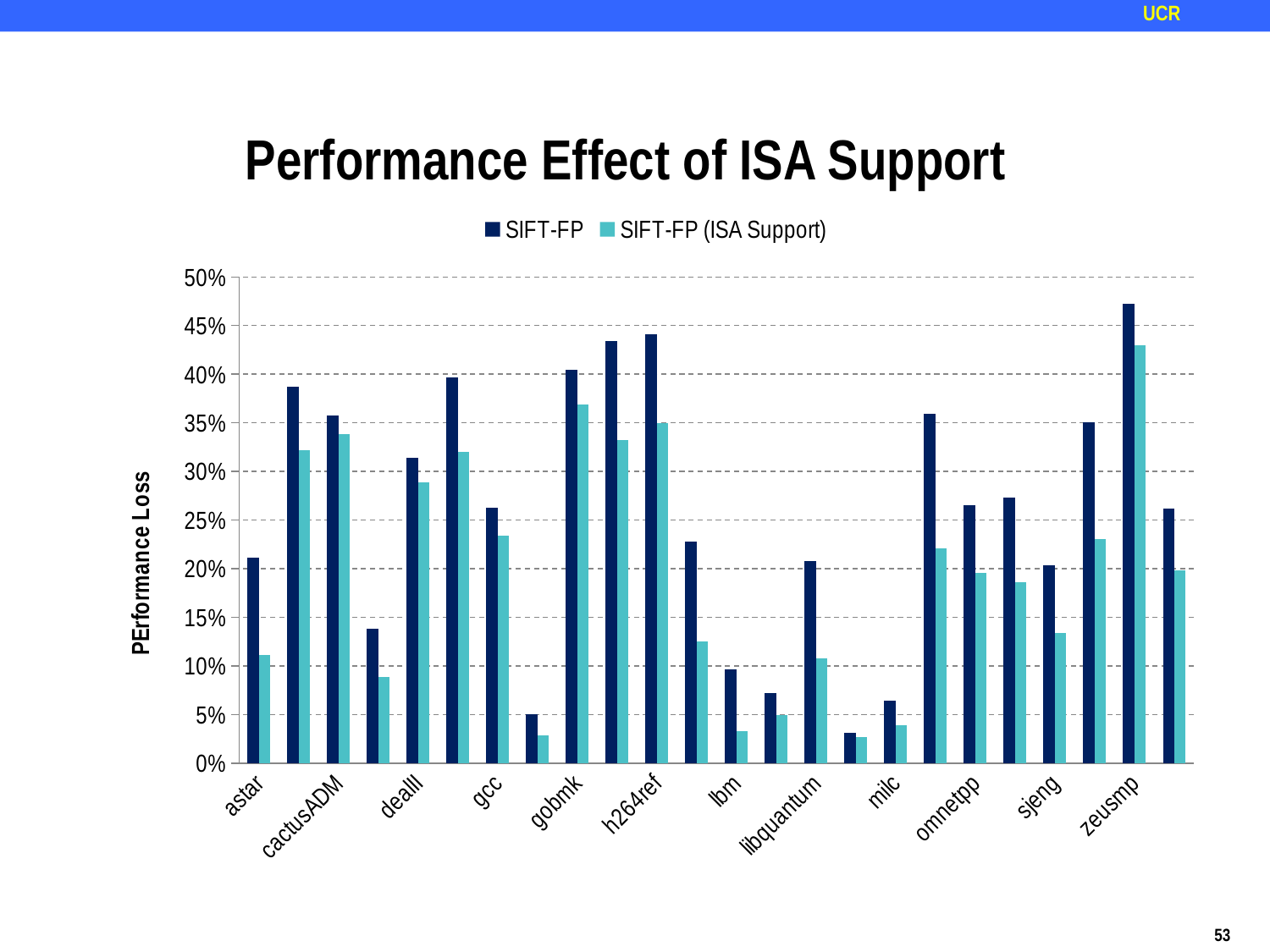
Which labeled benchmark has the highest SIFT-FP performance loss? zeusmp Is the SIFT-FP value for milc greater or less than 10%? less Is the SIFT-FP value for h264ref greater or less than 40%? greater What is the title of the chart? Performance Effect of ISA Support What kind of chart is shown on the slide? bar chart Which has the larger SIFT-FP value: h264ref or gcc? h264ref What is the label on the vertical axis? PErformance Loss For astar, which series has the larger value: SIFT-FP or SIFT-FP (ISA Support)? SIFT-FP Is the SIFT-FP (ISA Support) value for lbm greater or less than 5%? less How many series does the legend list? 2